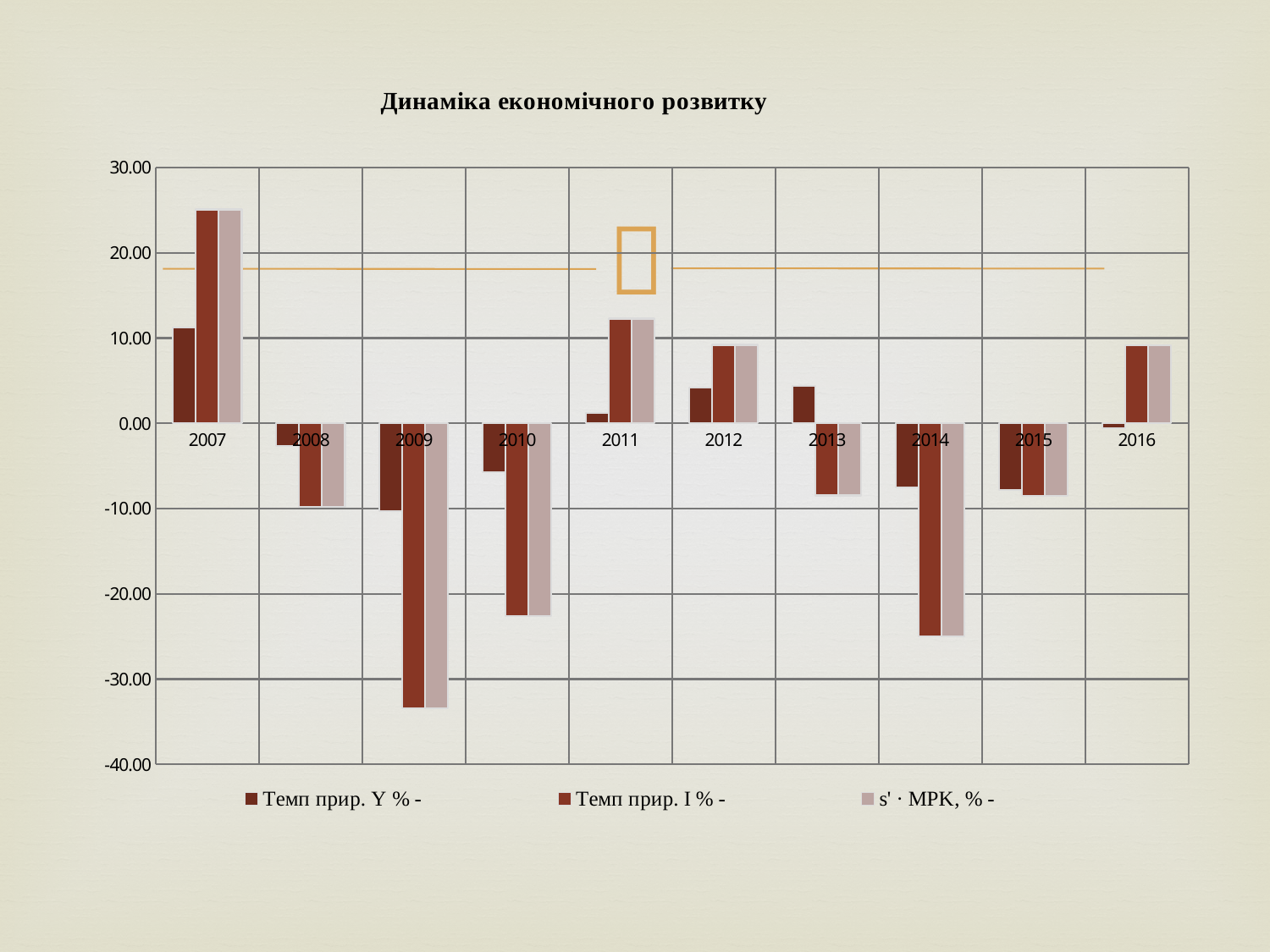
Is the value for Темп прир. I % in 2007 greater or less than 20.00? greater How many years are shown on the x axis? 10 Which is larger: the value for Темп прир. I % in 2007 or in 2011? 2007 What type of chart is shown on the slide? bar chart In which year is the value for Темп прир. I % the highest? 2007 How many series does the legend list? 3 Is the value for Темп прир. I % in 2009 greater or less than -30.00? less What is the title of the chart? Динаміка економічного розвитку Is the value for Темп прир. I % in 2014 greater or less than -20.00? less In which year is the value for Темп прир. I % the lowest? 2009 In which year is the value for Темп прир. Y % the highest? 2007